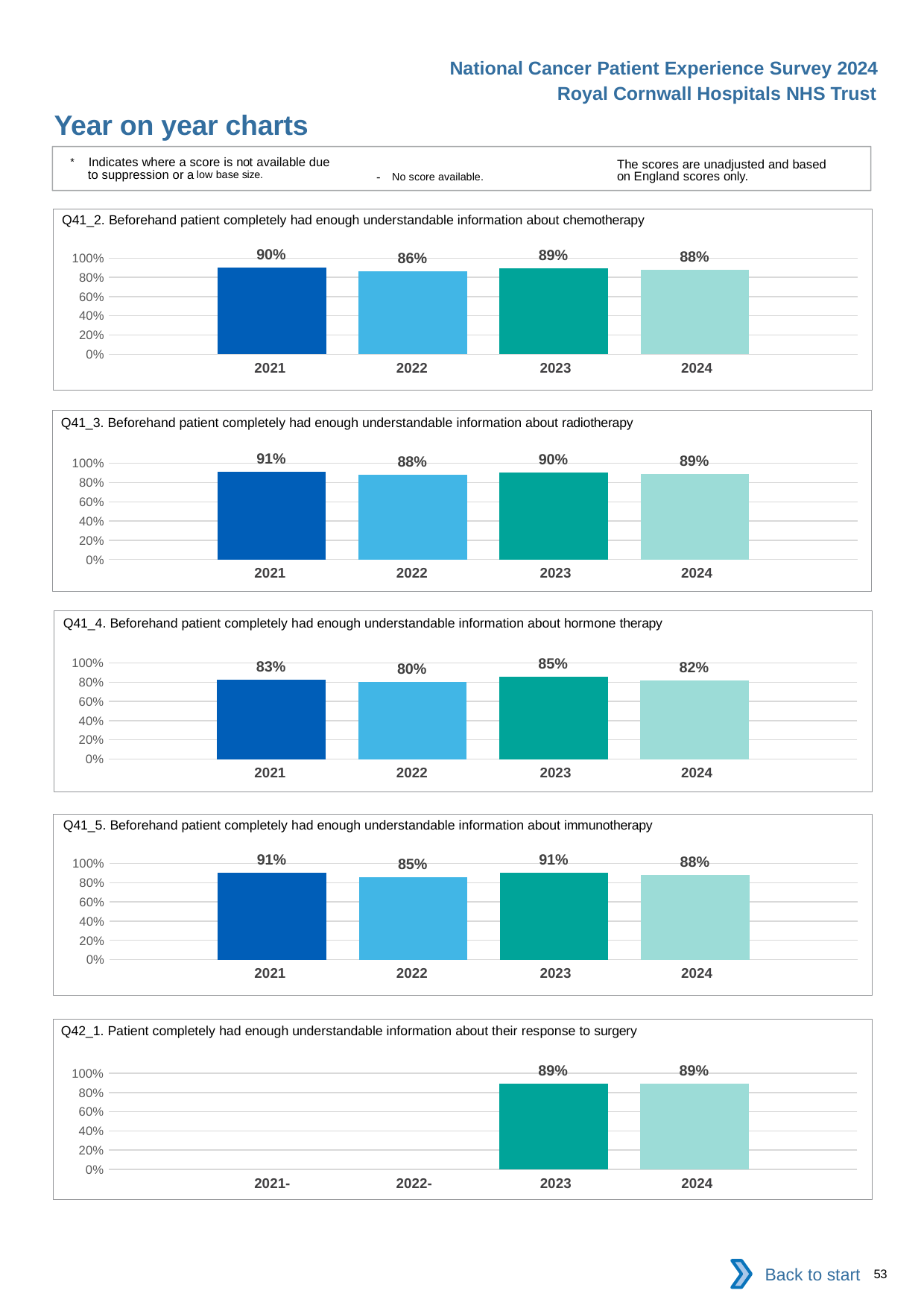
In the Q41_4 chart about hormone therapy, which year has the highest value? 2023 In the Q41_2 chart about chemotherapy, which year has the highest value? 2021 How many charts are shown on the slide? 5 In the Q42_1 chart about response to surgery, how many years have a bar plotted? 2 In the Q41_5 chart about immunotherapy, is the value for 2021 larger or smaller than the value for 2024? larger In the Q41_4 chart about hormone therapy, what is the difference between the 2023 and 2022 values? 5 percentage points In the Q41_2 chart about chemotherapy, what is the value for 2022? 86% In the Q41_5 chart about immunotherapy, what is the value for 2022? 85% In the Q41_3 chart about radiotherapy, which year has the lowest value? 2022 In the Q41_3 chart about radiotherapy, what is the value for 2024? 89% What kind of chart is the Q41_2 chart about chemotherapy? Bar chart In the Q42_1 chart about response to surgery, what is the value for 2023? 89%